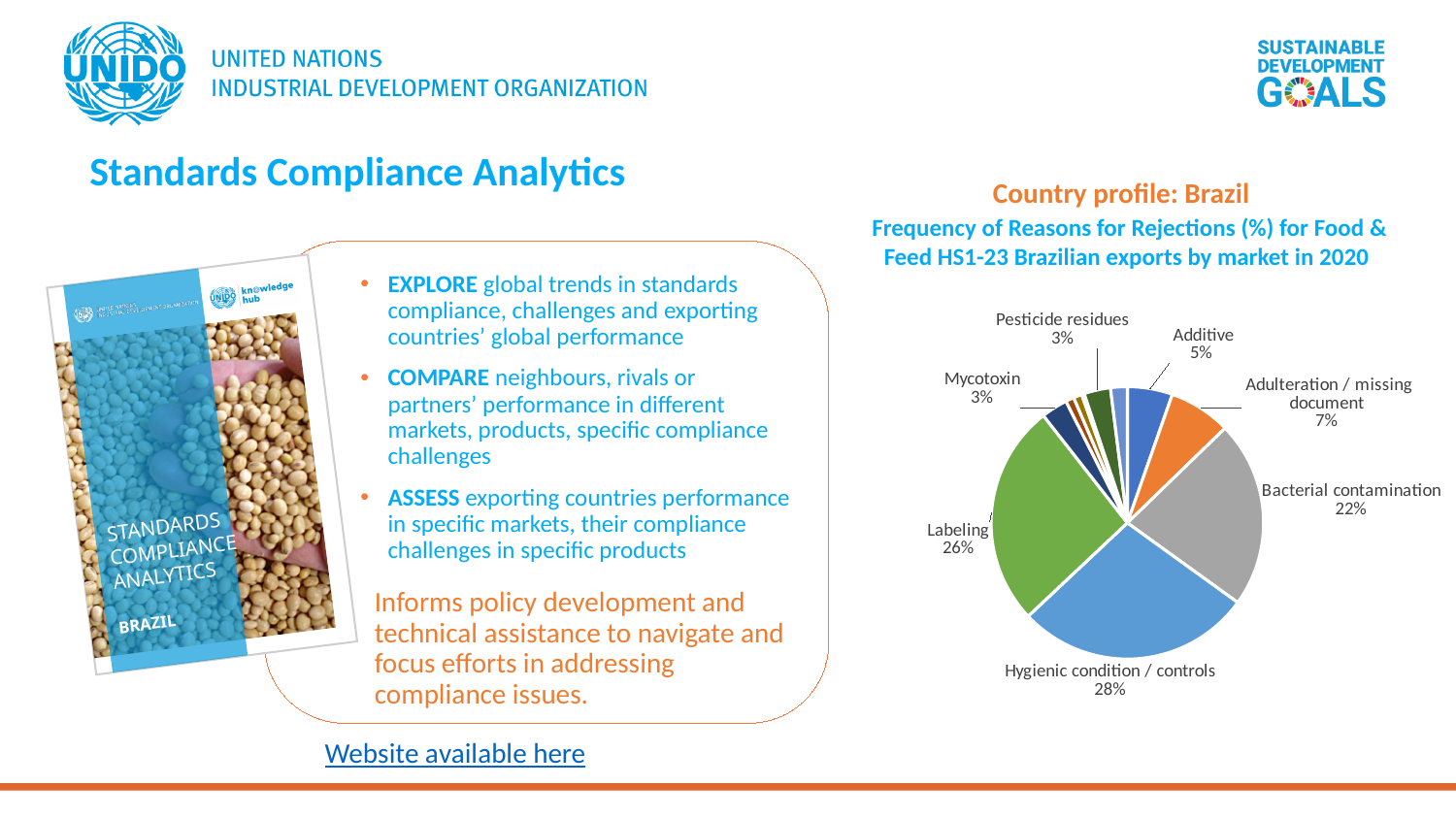
What is the difference in percentage points between Hygienic condition / controls and Labeling? 2 percentage points What percentage of rejections is attributed to Hygienic condition / controls? 28% What is the difference in percentage points between Bacterial contamination and Adulteration / missing document? 15 percentage points What percentage of rejections is attributed to Adulteration / missing document? 7% Which is larger, the share for Labeling or the share for Bacterial contamination? Labeling Which reason for rejection has the largest share of the pie? Hygienic condition / controls Which country does the pie chart's country profile cover? Brazil What type of chart is shown on the slide? Pie chart What percentage of rejections is attributed to Mycotoxin? 3% What percentage of rejections is attributed to Bacterial contamination? 22% What percentage of rejections is attributed to Labeling? 26% What percentage of rejections is attributed to Additive? 5%